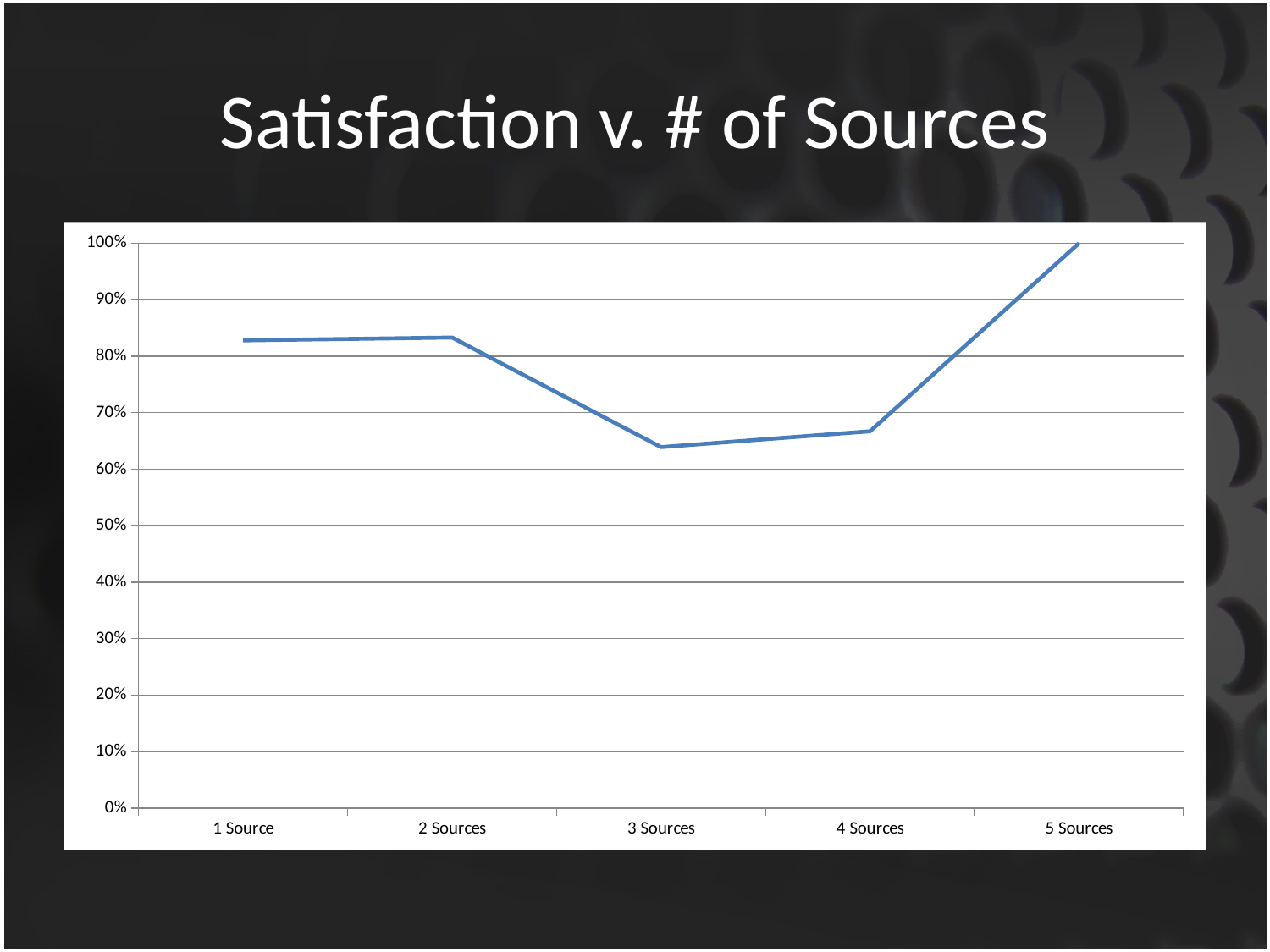
Is the value for 4 Sources greater or less than 70%? less Is the value for 1 Source greater or less than 80%? greater Which is larger, the value for 1 Source or the value for 3 Sources? 1 Source Does the line rise or fall from 2 Sources to 3 Sources? Falls Does the line rise or fall from 4 Sources to 5 Sources? Rises Is the value for 3 Sources greater or less than 70%? less Which category has the highest satisfaction value? 5 Sources How many categories are shown on the x axis? 5 What is the title of the chart? Satisfaction v. # of Sources What is the satisfaction value for 5 Sources? 100% What kind of chart is shown on the slide? Line chart